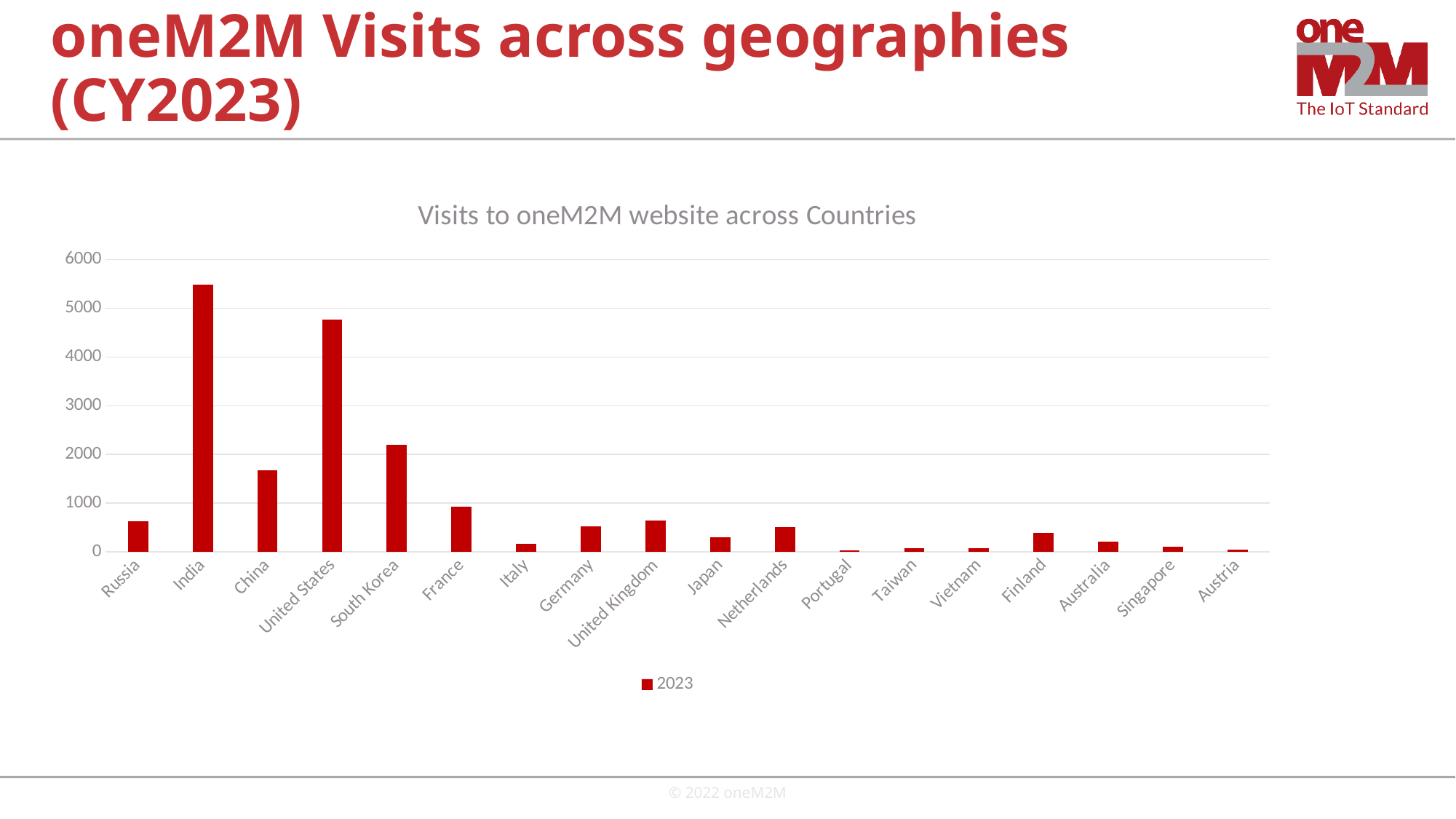
Which country has the highest number of visits to the oneM2M website? India Is the value for South Korea greater or less than 3000? less Is the value for China greater or less than 1000? greater How many countries are shown on the x axis of the chart? 18 Which has more visits, Finland or Australia? Finland Is the value for India greater or less than 5000? greater What kind of chart is shown on the slide? bar chart Which has more visits, United Kingdom or Japan? United Kingdom How many series does the legend list? 1 What is the title of the chart? Visits to oneM2M website across Countries